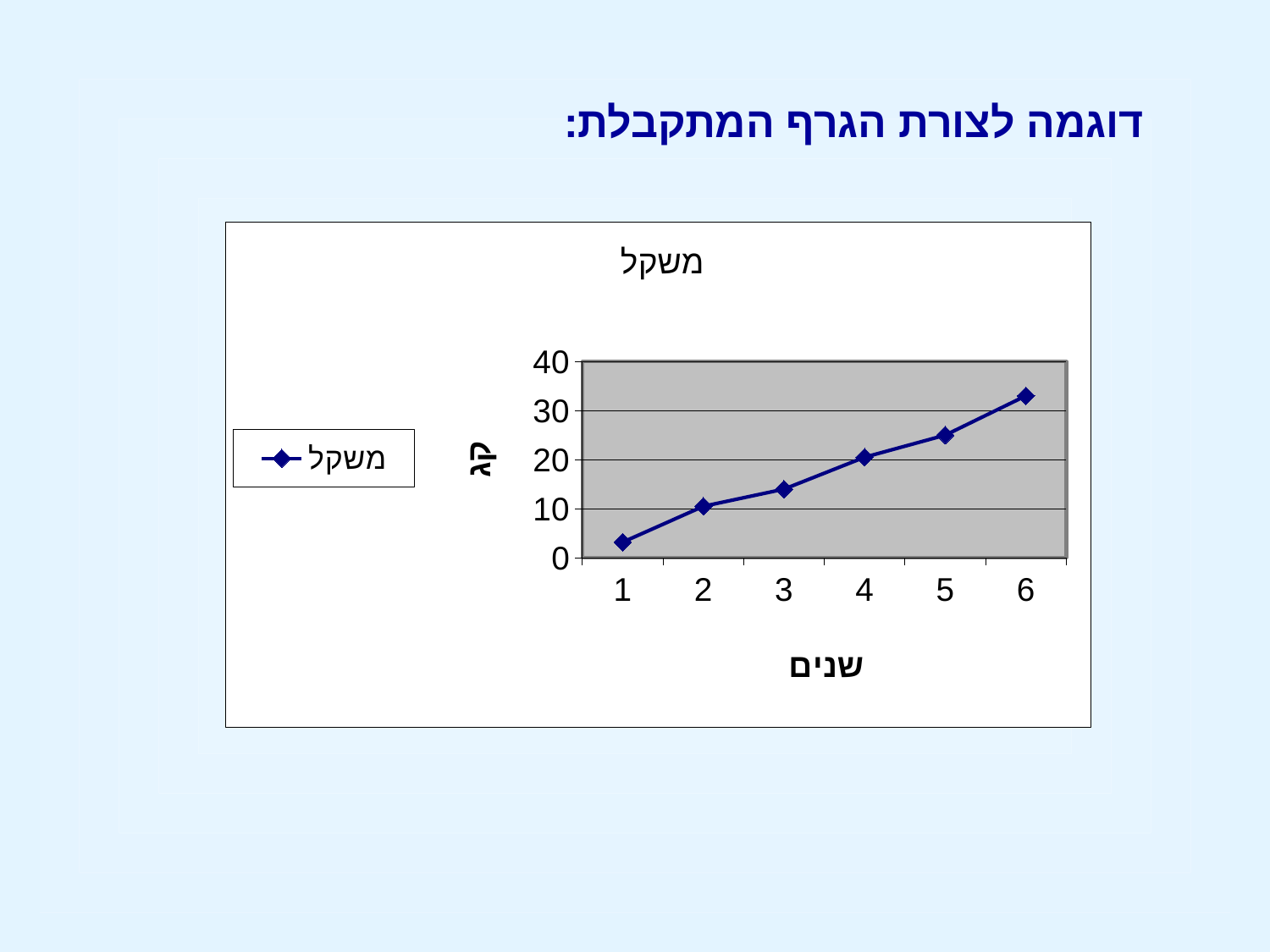
Is the value for year 1 greater or less than 10? less What kind of chart is shown on the slide? line chart How many data points are plotted on the line? 6 Is the value for year 5 greater or less than 20? greater Which is larger, the value for year 5 or the value for year 2? year 5 Do the values rise or fall as the years increase along the x axis? rise How many series does the legend list? 1 What is the title of the chart? משקל Is the value for year 6 greater or less than 30? greater At which year is the value highest? 6 At which year is the value lowest? 1